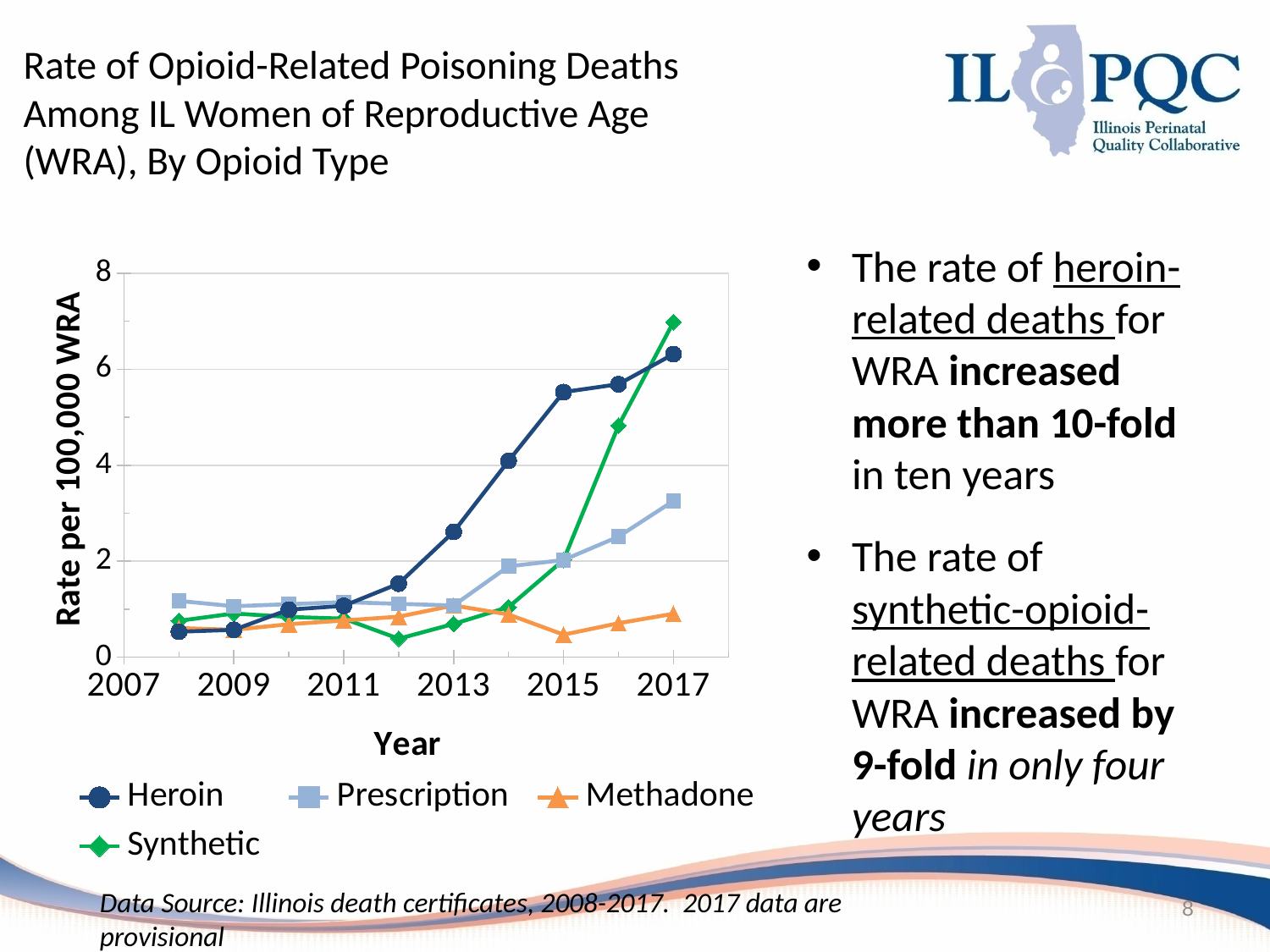
What is the label on the y axis? Rate per 100,000 WRA What kind of chart is shown on the slide? line chart Is the value for Methadone in 2017 greater or less than 2? less Which series has the highest value in 2017? Synthetic How many series does the legend list? 4 Is the value for Heroin in 2017 greater or less than 6? greater Does the Heroin series generally rise or fall from 2008 to 2017? rise Is the value for Prescription in 2017 greater or less than 2? greater What is the label on the x axis? Year Which series has the lowest value in 2017? Methadone In 2016, which is larger, the value for Heroin or the value for Methadone? Heroin